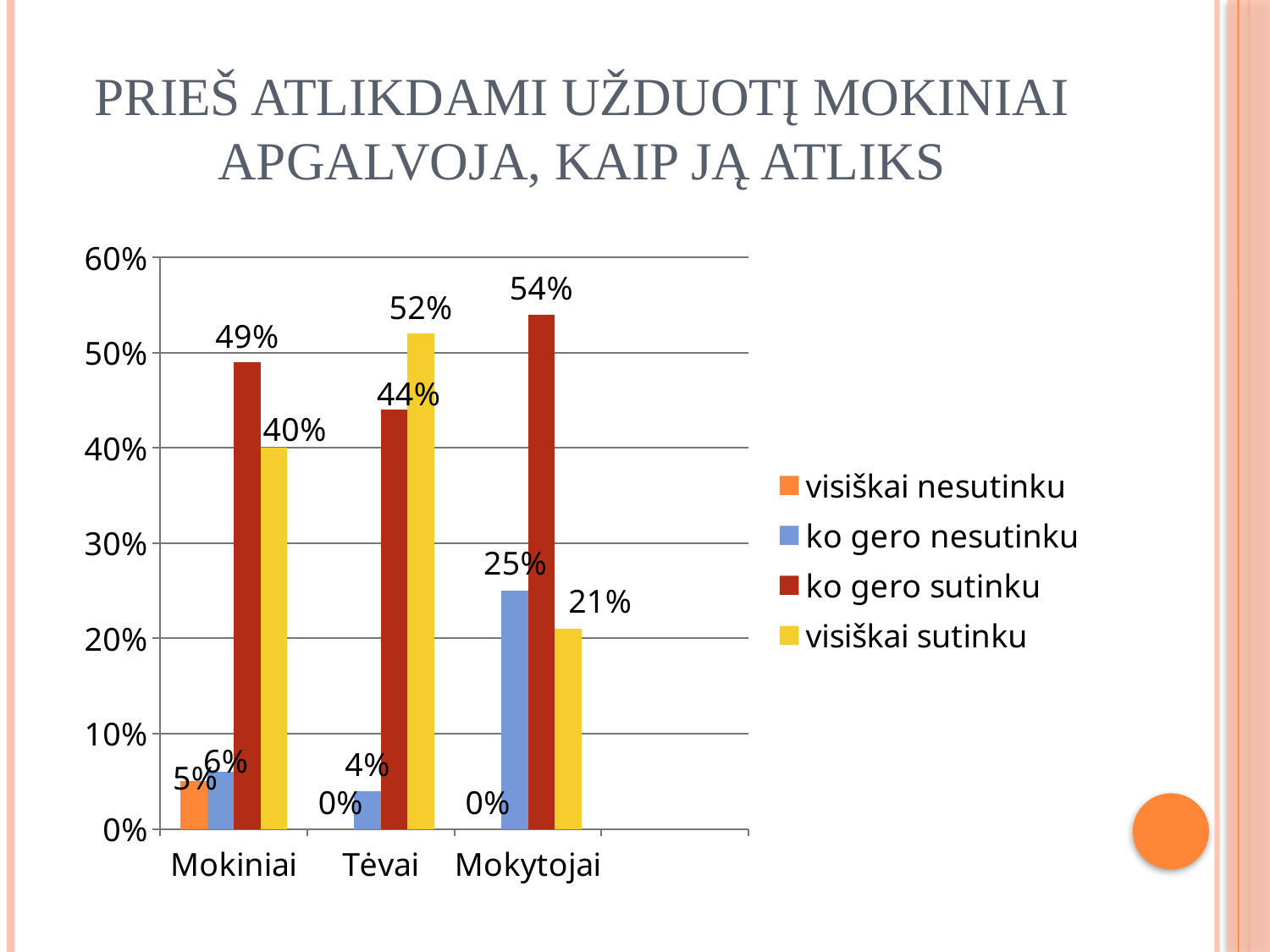
What kind of chart is shown on the slide? bar chart How many series does the legend list? 4 Which category has the lowest value for 'visiškai sutinku'? Mokytojai Which series is shown in yellow in the legend? visiškai sutinku What is the value of 'visiškai sutinku' for Tėvai? 52% Which category has the highest value for 'ko gero sutinku'? Mokytojai How many categories are shown on the x axis? 3 What is the value of 'visiškai nesutinku' for Mokiniai? 5% Which is larger: 'ko gero sutinku' for Mokiniai or 'visiškai sutinku' for Mokiniai? ko gero sutinku for Mokiniai What is the value of 'ko gero sutinku' for Mokytojai? 54% What is the value of 'ko gero nesutinku' for Mokytojai? 25% What is the difference between 'visiškai sutinku' for Tėvai and for Mokiniai? 12%